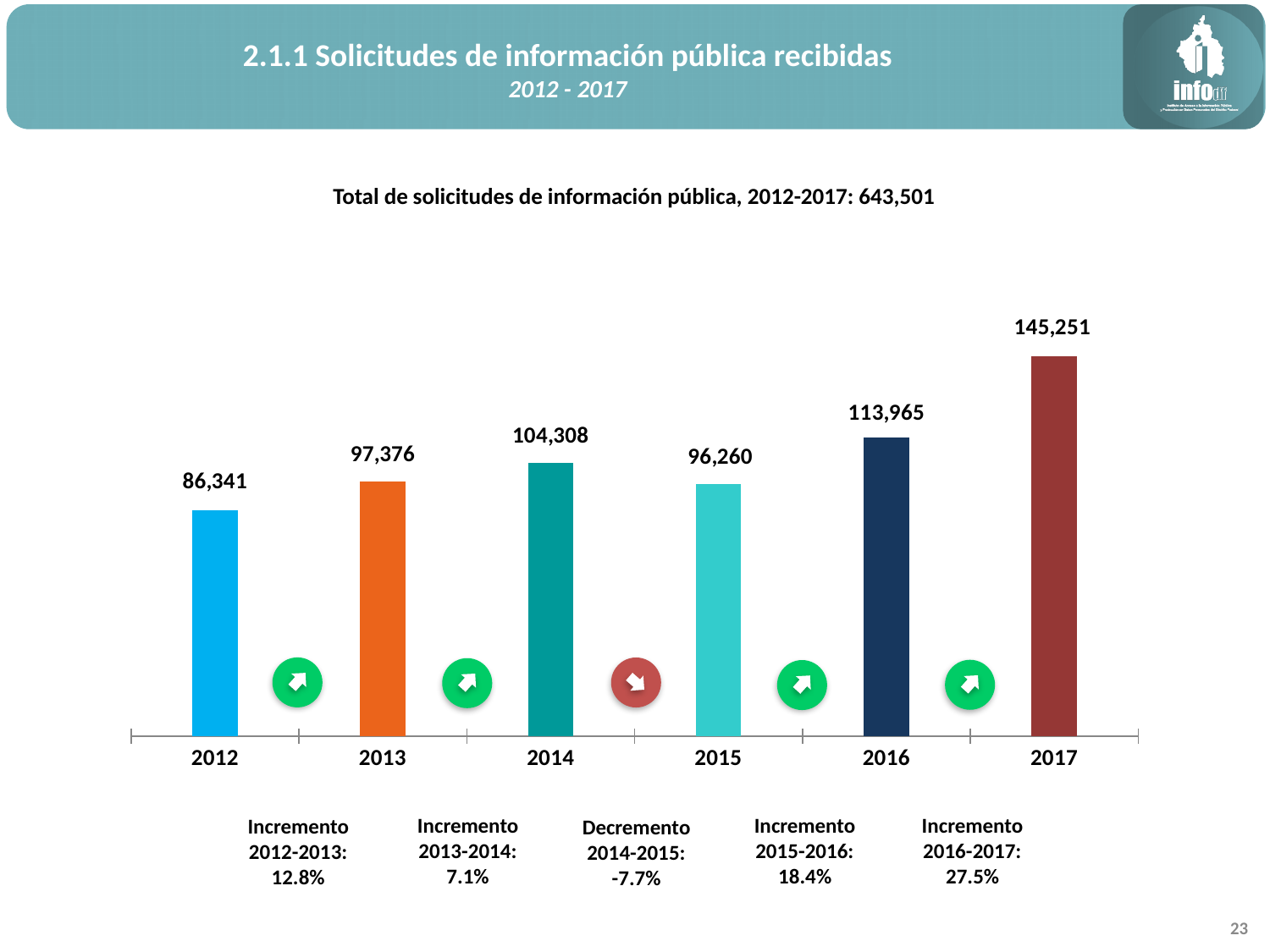
How many years are shown on the x axis? 6 Which year has the highest value? 2017 What is the value for 2012? 86,341 What kind of chart is shown on the slide? bar chart Which is larger, the value for 2013 or the value for 2015? 2013 What is the value for 2017? 145,251 What is the difference between the values for 2014 and 2015? 8,048 What is the percentage change shown for 2014-2015? -7.7% What is the value for 2015? 96,260 What total of solicitudes for 2012-2017 is stated above the chart? 643,501 Which year has the lowest value? 2012 What is the difference between the values for 2017 and 2016? 31,286